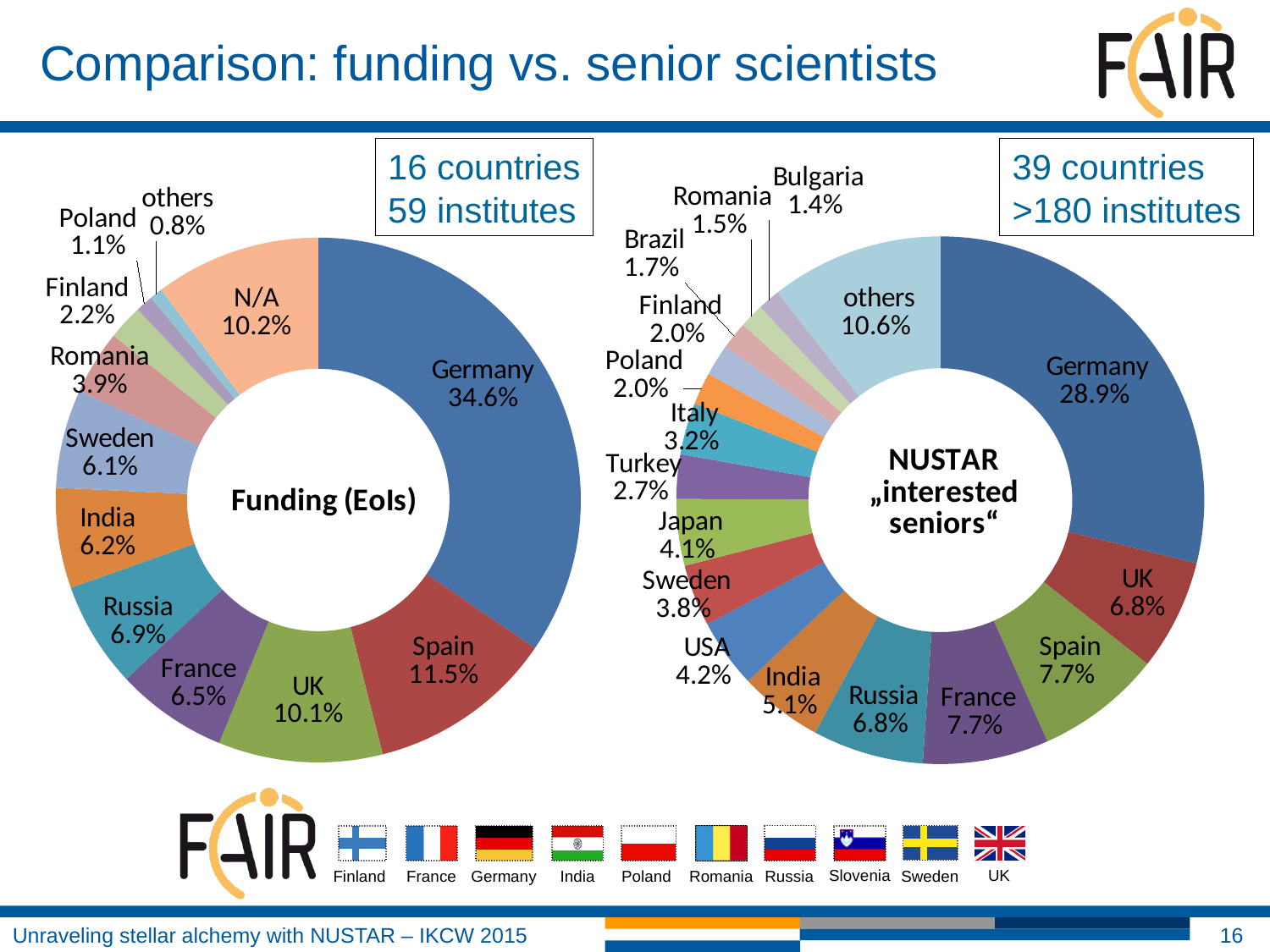
In the Funding (EoIs) chart, which is larger, the share for Russia or the share for France? Russia In the NUSTAR "interested seniors" chart, which country has the smallest share? Bulgaria In the Funding (EoIs) chart, what share does Germany have? 34.6% In the Funding (EoIs) chart, what share does Spain have? 11.5% What is the difference between Germany's share in the Funding (EoIs) chart and Germany's share in the NUSTAR "interested seniors" chart? 5.7% In the NUSTAR "interested seniors" chart, what is the difference between the shares of Spain and UK? 0.9% What kind of chart is the Funding (EoIs) chart? Pie chart (donut) In the Funding (EoIs) chart, which slice has the smallest share? others In the NUSTAR "interested seniors" chart, what share does the USA have? 4.2% In the Funding (EoIs) chart, which country has the largest share? Germany How many slices does the NUSTAR "interested seniors" chart have? 17 In the NUSTAR "interested seniors" chart, what share does Germany have? 28.9%